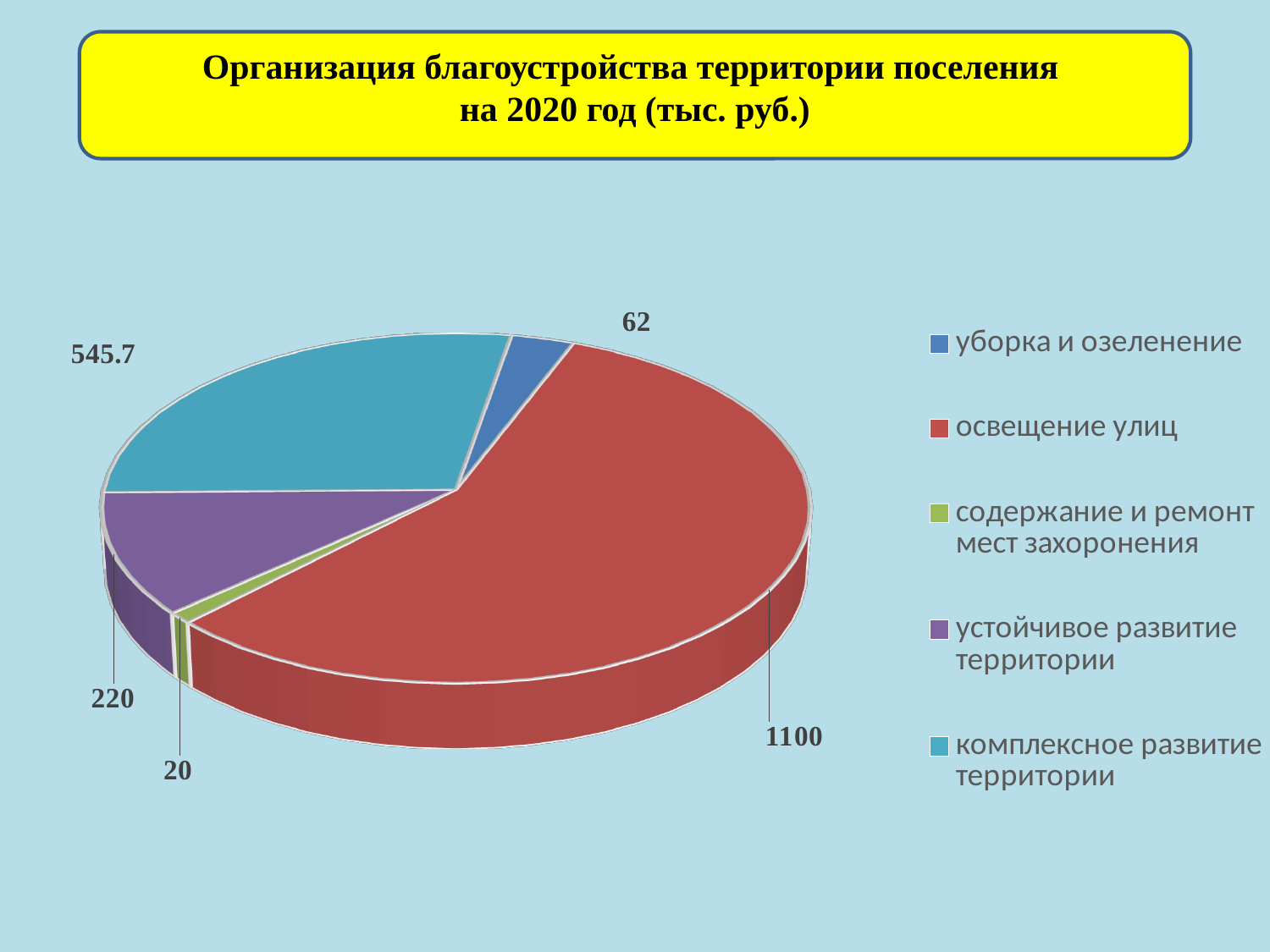
What kind of chart is shown on the slide? pie chart What is the value for содержание и ремонт мест захоронения? 20 What is the value for уборка и озеленение? 62 Which category has the lowest value? содержание и ремонт мест захоронения What is the value for освещение улиц? 1100 Which category has the highest value? освещение улиц Which is larger, the value for устойчивое развитие территории or the value for уборка и озеленение? устойчивое развитие территории What colour is the slice for комплексное развитие территории? teal (blue-green) How many slices does the pie chart have? 5 What is the value for комплексное развитие территории? 545.7 What is the total of all the slices in the pie chart? 1947.7 What is the difference between the values for освещение улиц and комплексное развитие территории? 554.3